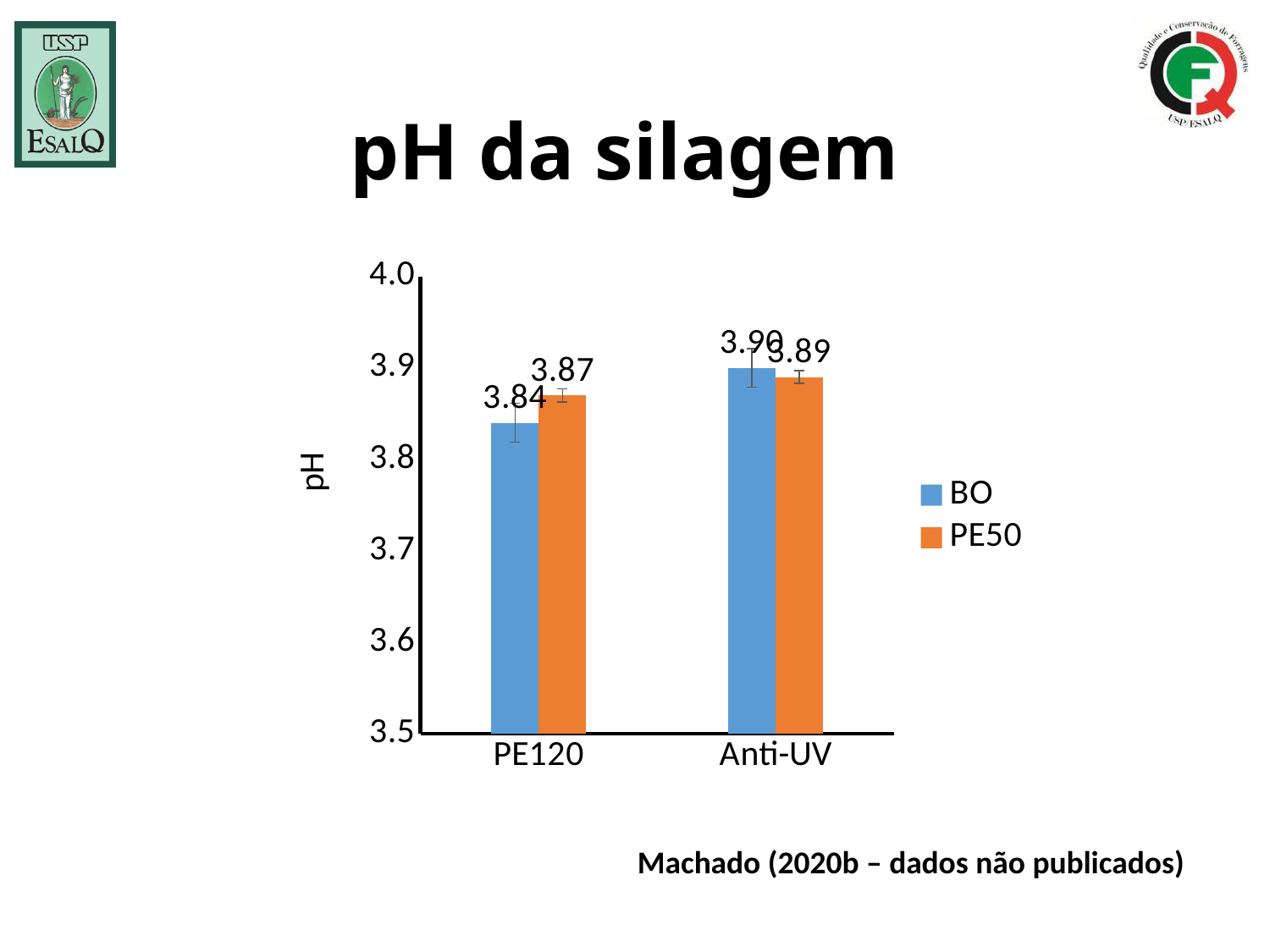
How many categories are shown on the x axis? 2 Which bar has the lowest pH value? BO under PE120 What is the label of the y axis? pH What kind of chart is shown? bar chart Which is larger under PE120, the BO value or the PE50 value? PE50 What is the pH value for PE50 under PE120? 3.87 Is the value for BO under Anti-UV greater or less than 3.8? greater What is the pH value for PE50 under Anti-UV? 3.89 How many series does the legend list? 2 What is the difference between the PE50 and BO values under PE120? 0.03 What is the pH value for BO under Anti-UV? 3.90 What is the pH value for BO under PE120? 3.84